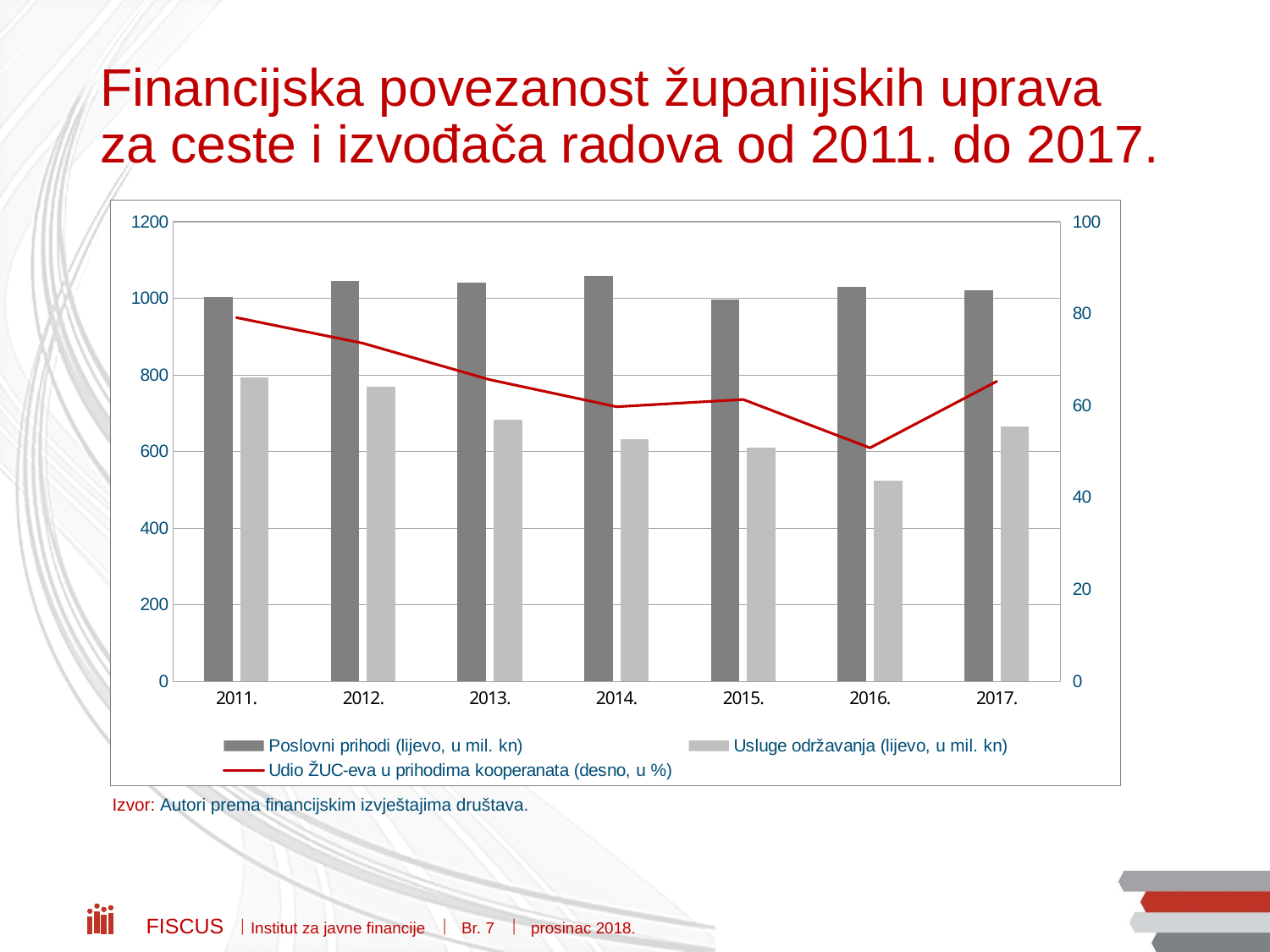
In which year is the Udio ŽUC-eva u prihodima kooperanata line at its highest? 2011. How many series does the chart legend list? 3 Does the Usluge održavanja series rise or fall from 2011. to 2016.? fall Which series is drawn as a red line in the chart? Udio ŽUC-eva u prihodima kooperanata (desno, u %) Is the Poslovni prihodi value for 2014. greater or less than 1000? greater What kind of chart is shown on the slide? Bar chart with a line series How many years are shown on the x axis of the chart? 7 Is the Udio ŽUC-eva u prihodima kooperanata value for 2016. greater or less than 60? less Which is larger, the Usluge održavanja value for 2012. or for 2016.? 2012. In which year is the Udio ŽUC-eva u prihodima kooperanata line at its lowest? 2016. In which year is the Usluge održavanja bar lowest? 2016. Is the Usluge održavanja value for 2016. greater or less than 600? less